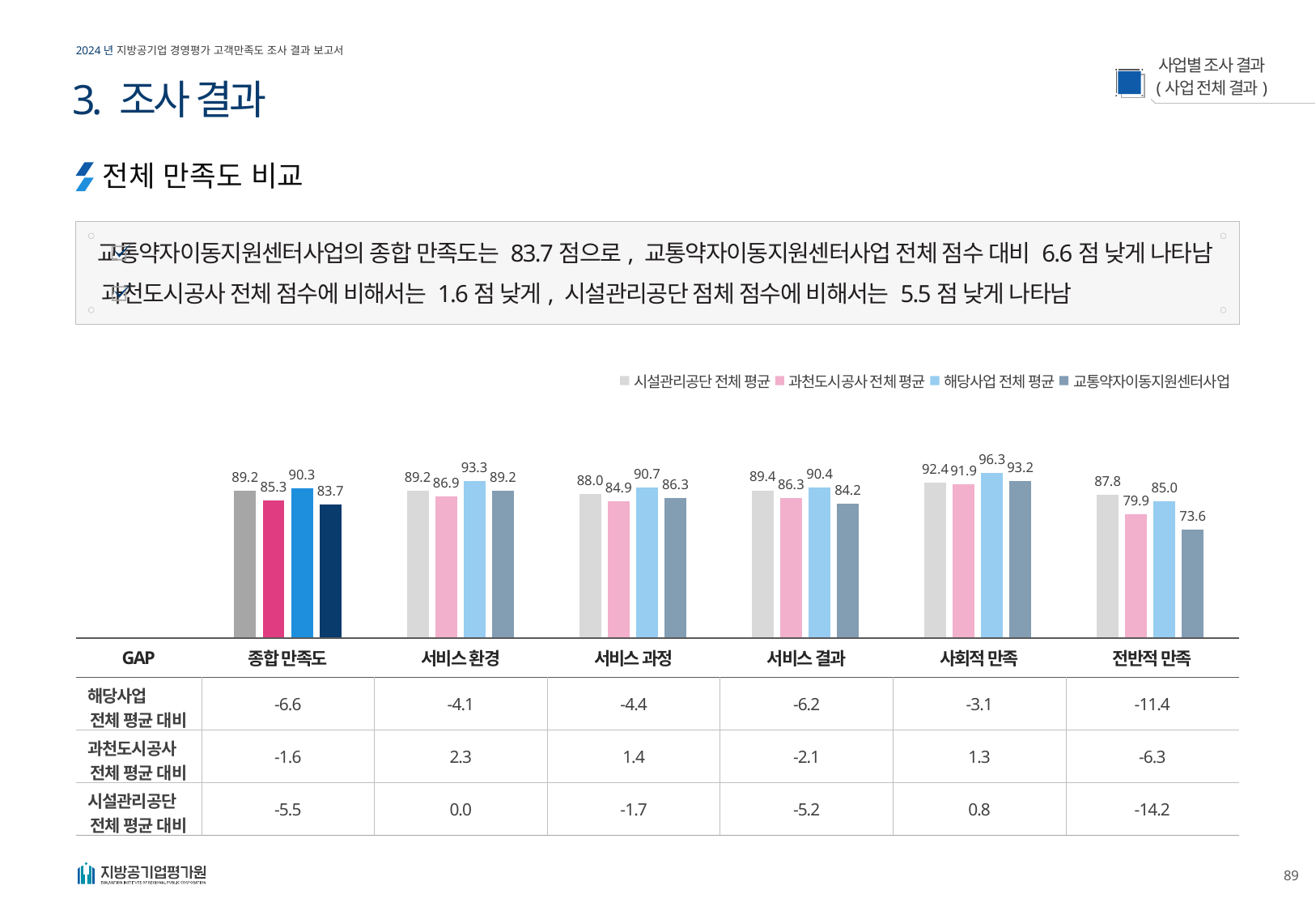
In which category does 교통약자이동지원센터사업 have its lowest value? 전반적 만족 How many categories are shown on the x axis of the chart? 6 What kind of chart is shown on the slide? Bar chart What is the difference between 해당사업 전체 평균 and 교통약자이동지원센터사업 in the 서비스 결과 category? 6.2 How many series does the chart legend list? 4 Which is larger in the 서비스 과정 category: 시설관리공단 전체 평균 or 교통약자이동지원센터사업? 시설관리공단 전체 평균 What is the value for 교통약자이동지원센터사업 in the 종합 만족도 category? 83.7 What is the value for 과천도시공사 전체 평균 in the 전반적 만족 category? 79.9 What is the value for 시설관리공단 전체 평균 in the 사회적 만족 category? 92.4 In which category does 해당사업 전체 평균 have its highest value? 사회적 만족 What is the value for 해당사업 전체 평균 in the 서비스 환경 category? 93.3 Which series is shown in pink in the chart legend? 과천도시공사 전체 평균